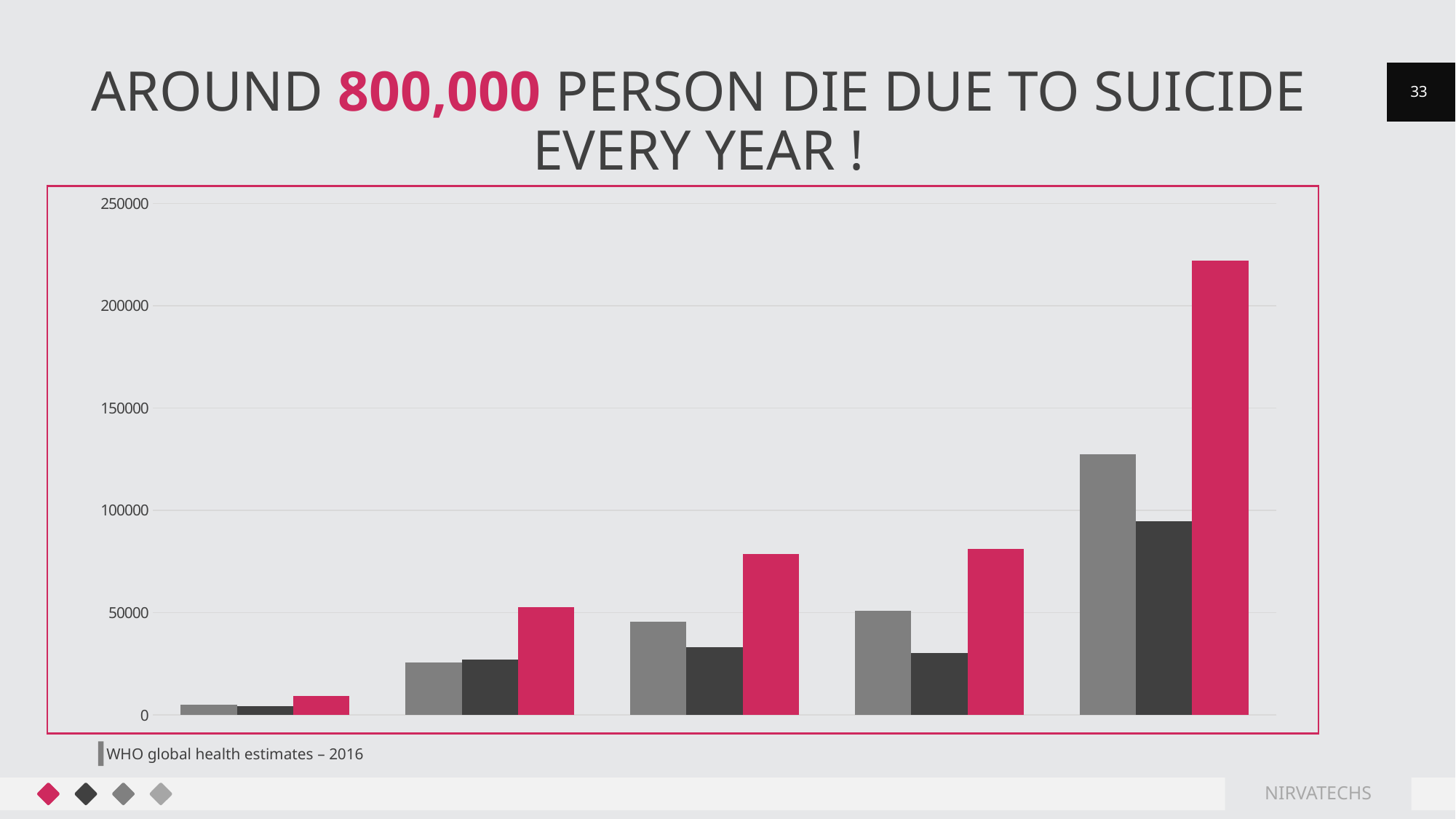
What source is cited below the chart? WHO global health estimates – 2016 Which group of bars contains the tallest bar in the chart? the rightmost group Is the value of the pink bar in the rightmost group greater or less than 200000? greater How many bars are there in each group of the chart? 3 Do the pink bars rise or fall from left to right across the chart? rise How many groups of bars are plotted in the chart? 5 Is the value of the pink bar in the second group from the left greater or less than 50000? greater Is the value of the light grey bar in the rightmost group greater or less than 150000? less What kind of chart is shown on the slide? bar chart Which colour of bar is the tallest in the chart? pink